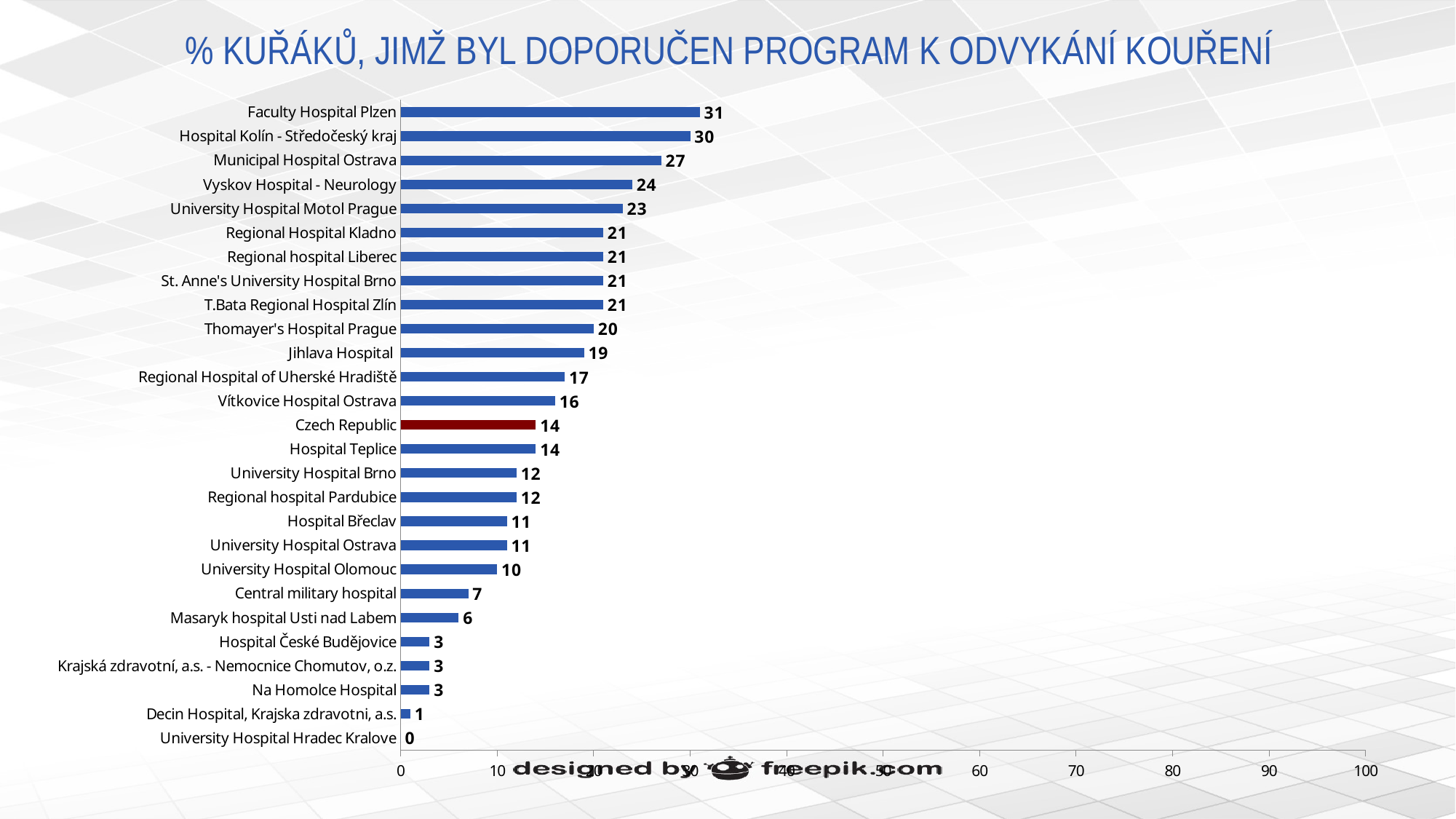
What is the difference between the values for Faculty Hospital Plzen and Czech Republic? 17 Which category has the highest value? Faculty Hospital Plzen Which bar is shown in a different colour (dark red) from the others? Czech Republic What is the value for Faculty Hospital Plzen? 31 What is the value for Czech Republic? 14 Which is larger, the value for Jihlava Hospital or the value for Vítkovice Hospital Ostrava? Jihlava Hospital How many categories are shown in the chart? 27 Which category has the lowest value? University Hospital Hradec Kralove What is the value for University Hospital Olomouc? 10 What kind of chart is shown on the slide? bar chart Is the value for Municipal Hospital Ostrava greater or less than 20? greater What is the value for Masaryk hospital Usti nad Labem? 6